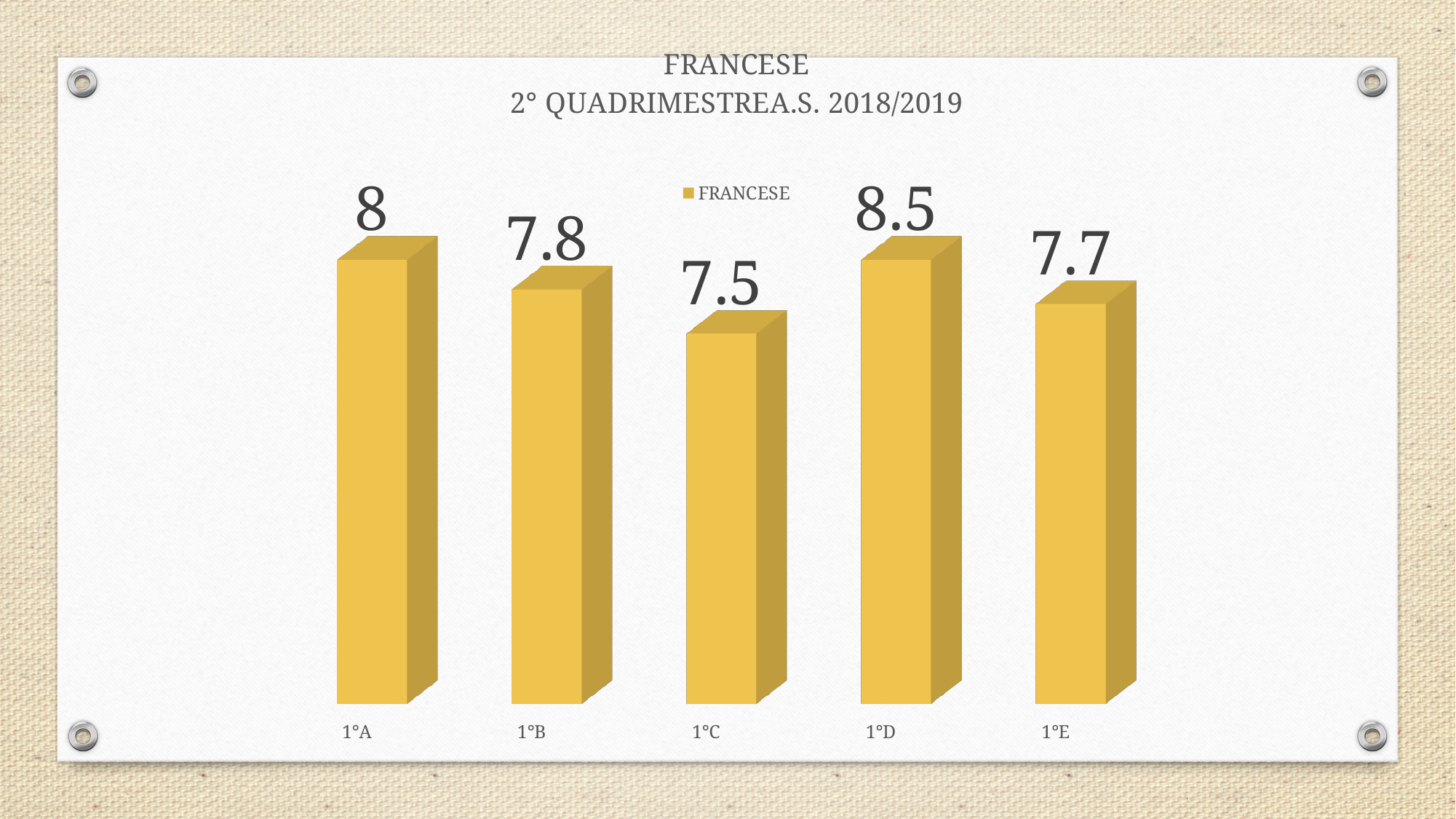
What is the value for 1°A? 8 What is the difference between the values for 1°D and 1°C? 1 What is the value for 1°E? 7.7 Which class has the lowest value? 1°C What kind of chart is shown? Bar chart What series name does the legend show? FRANCESE Which class has the highest value? 1°D What is the difference between the values for 1°A and 1°B? 0.2 What is the value for 1°C? 7.5 Which is larger, the value for 1°B or the value for 1°E? 1°B What is the value for 1°D? 8.5 How many classes are shown on the chart? 5